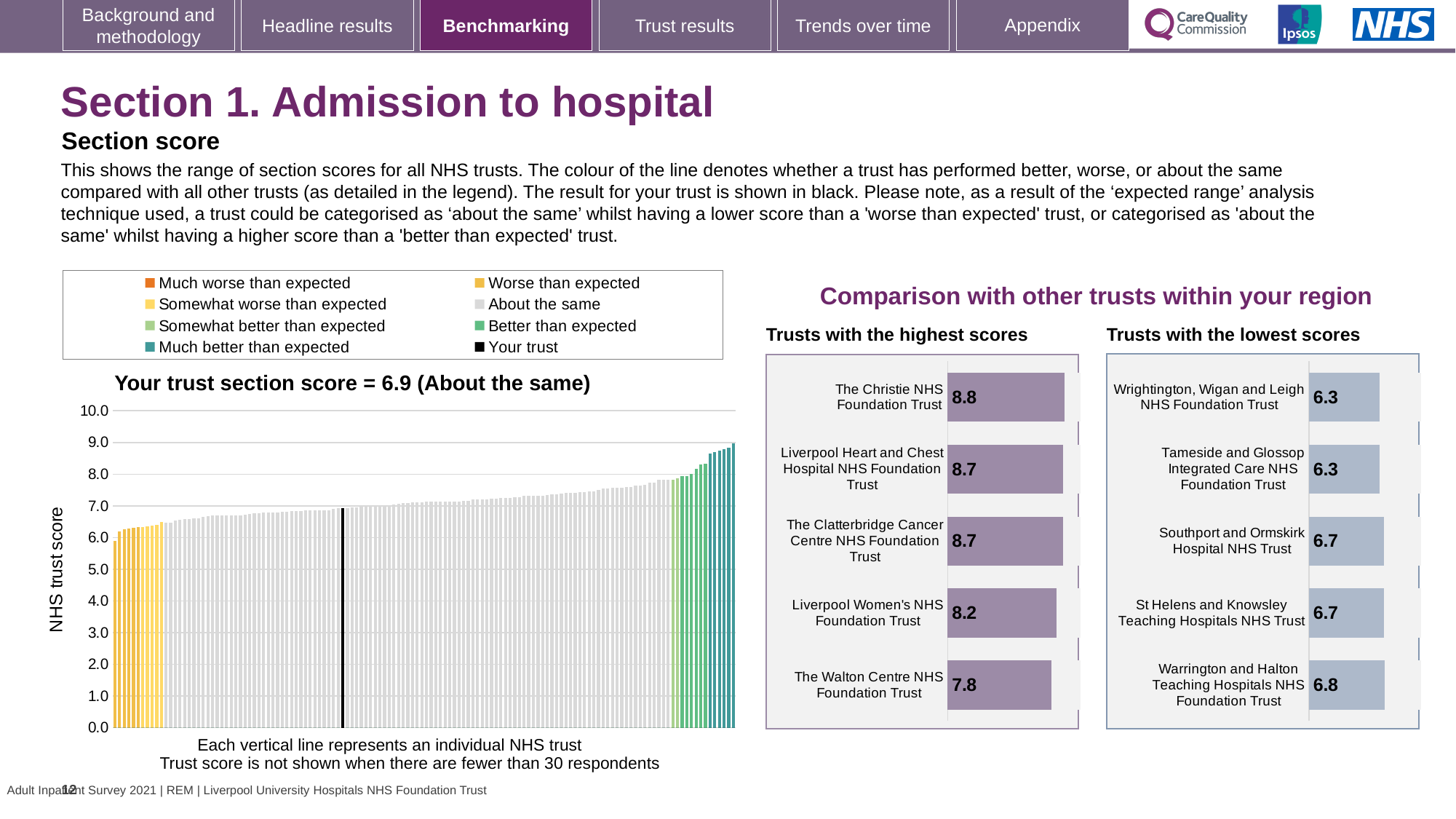
In the 'Trusts with the highest scores' chart, what is the score for The Walton Centre NHS Foundation Trust? 7.8 In the 'Trusts with the highest scores' chart, what is the difference between the scores of The Christie NHS Foundation Trust and The Walton Centre NHS Foundation Trust? 1.0 In the 'Trusts with the lowest scores' chart, what is the score for Warrington and Halton Teaching Hospitals NHS Foundation Trust? 6.8 In the 'Trusts with the highest scores' chart, how many trusts are shown? 5 In the 'Trusts with the lowest scores' chart, which is larger: the score for Southport and Ormskirk Hospital NHS Trust or for Wrightington, Wigan and Leigh NHS Foundation Trust? Southport and Ormskirk Hospital NHS Trust In the 'Your trust section score' chart, what is the section score for your trust? 6.9 In the 'Trusts with the lowest scores' chart, which trust has the highest score? Warrington and Halton Teaching Hospitals NHS Foundation Trust In the 'Trusts with the highest scores' chart, which trust has the lowest score? The Walton Centre NHS Foundation Trust In the 'Trusts with the lowest scores' chart, what is the difference between the scores of Warrington and Halton Teaching Hospitals NHS Foundation Trust and Wrightington, Wigan and Leigh NHS Foundation Trust? 0.5 In the 'Trusts with the highest scores' chart, what is the score for The Christie NHS Foundation Trust? 8.8 In the 'Your trust section score' chart, do the values rise or fall from left to right along the x axis? rise In the 'Your trust section score' chart, is the value of the rightmost bar greater or less than 8.0? greater